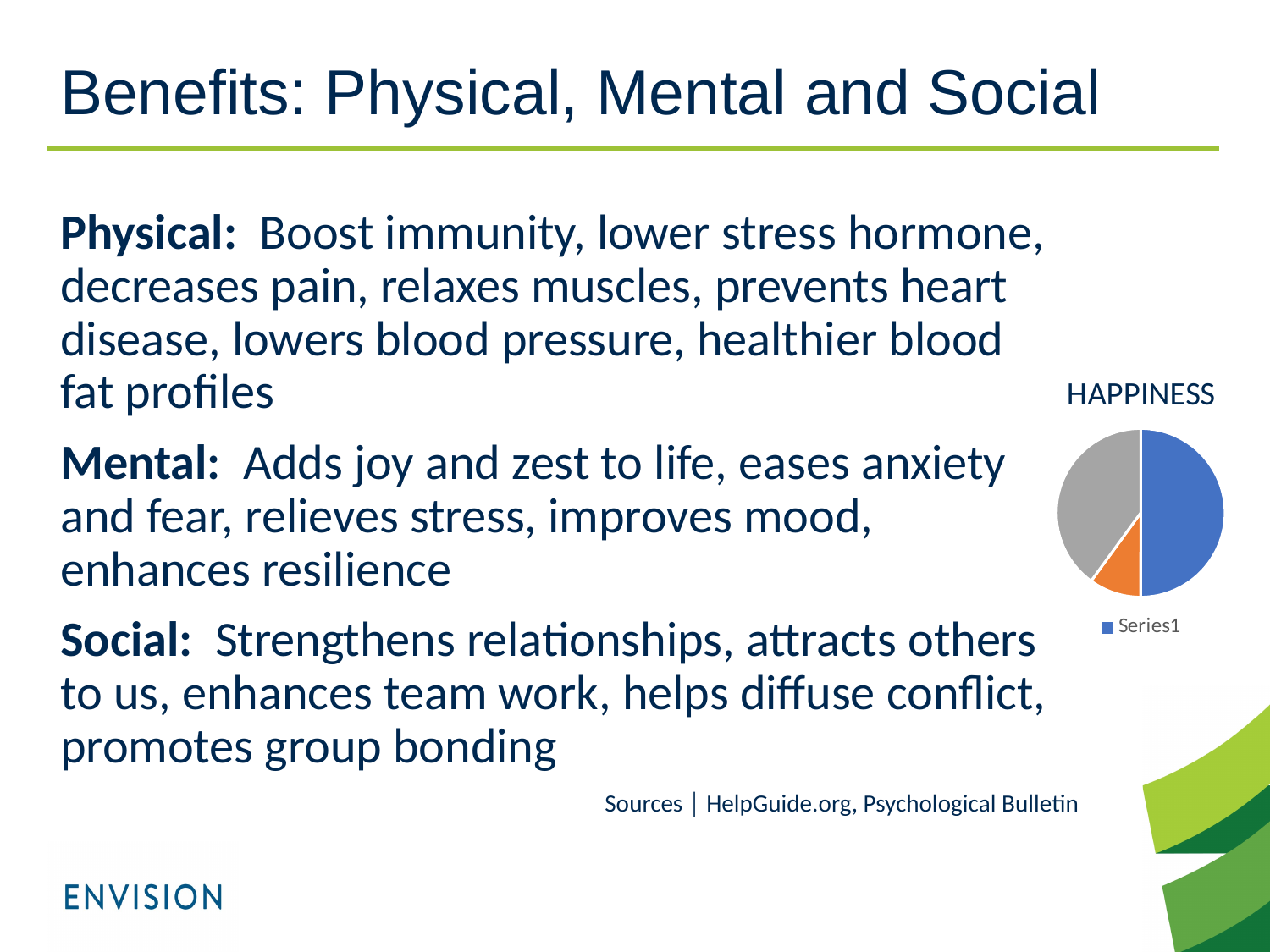
What is the legend entry shown for the HAPPINESS chart? Series1 How many slices does the HAPPINESS pie chart have? 3 In the HAPPINESS pie chart, is the gray slice or the orange slice larger? gray What kind of chart is shown on the slide? pie chart What is the title of the chart on the slide? HAPPINESS In the HAPPINESS pie chart, is the blue slice or the orange slice larger? blue Which colour slice is the smallest in the HAPPINESS pie chart? orange Which colour slice is the largest in the HAPPINESS pie chart? blue How many series does the legend of the HAPPINESS chart list? 1